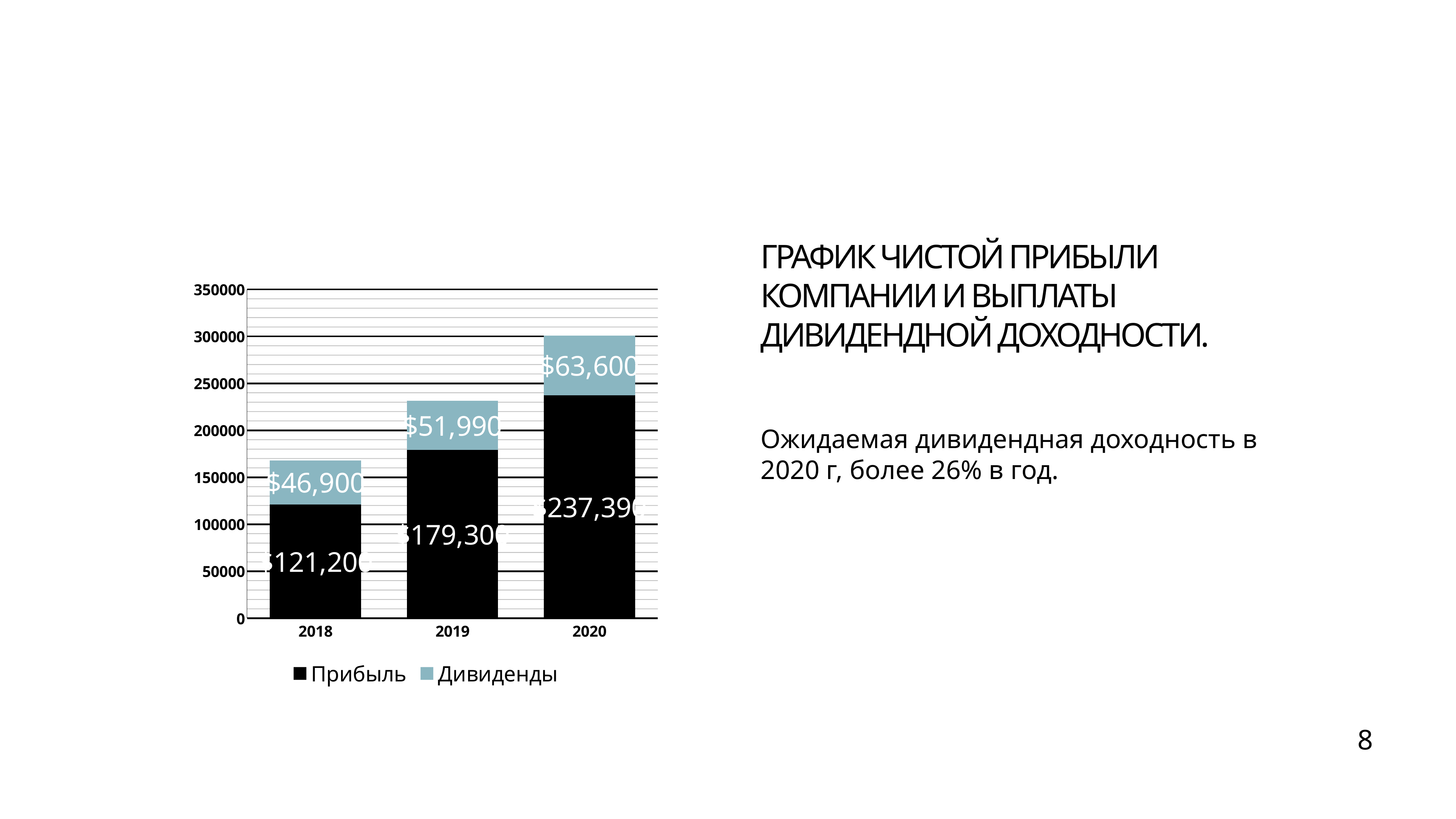
How many series does the legend list? 2 Which is larger: Дивиденды for 2019 or Дивиденды for 2020? Дивиденды for 2020 What is the value of Дивиденды for 2018? $46,900 What is the difference between the Прибыль values for 2020 and 2018? $116,190 Which year has the lowest Дивиденды value? 2018 Which year has the highest Прибыль value? 2020 What is the value of Дивиденды for 2020? $63,600 How many years are shown on the x axis? 3 What is the total of the stacked bar for 2020? $300,990 What is the value of Прибыль for 2019? $179,300 What is the total of the stacked bar for 2018? $168,100 Do the Прибыль values rise or fall from 2018 to 2020? rise